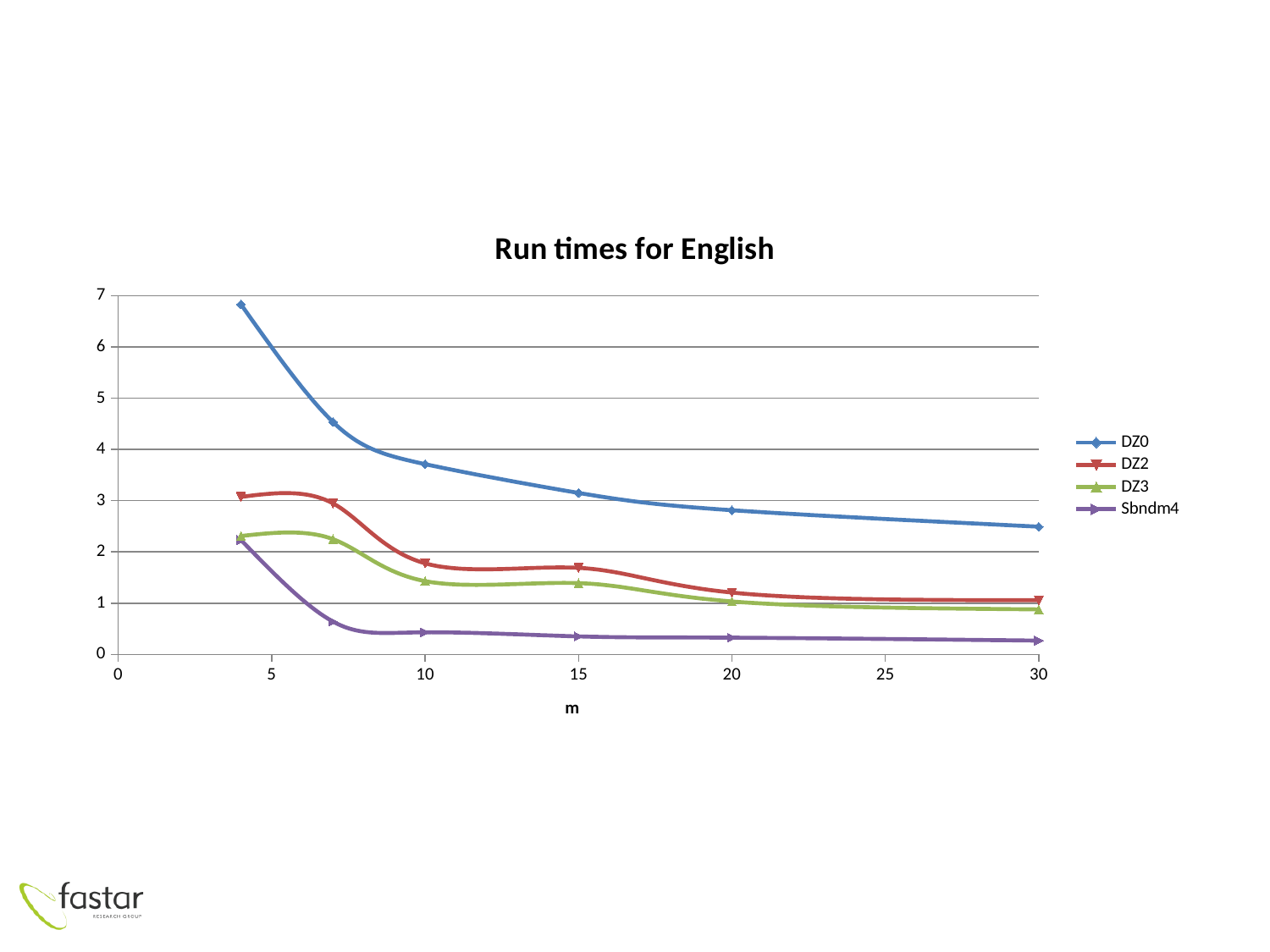
How many series does the legend list? 4 Is the value for DZ0 at m = 4 greater or less than 6? greater What is the label on the x axis? m Do the values for DZ0 rise or fall as m increases? fall Is the value for DZ2 at m = 15 greater or less than 2? less Which series has the highest value at m = 4? DZ0 What kind of chart is shown on the slide? line chart Is the value for DZ0 at m = 30 greater or less than 3? less Which series has the lowest value at m = 30? Sbndm4 What is the title of the chart? Run times for English Which is larger at m = 10, the value for DZ2 or the value for DZ3? DZ2